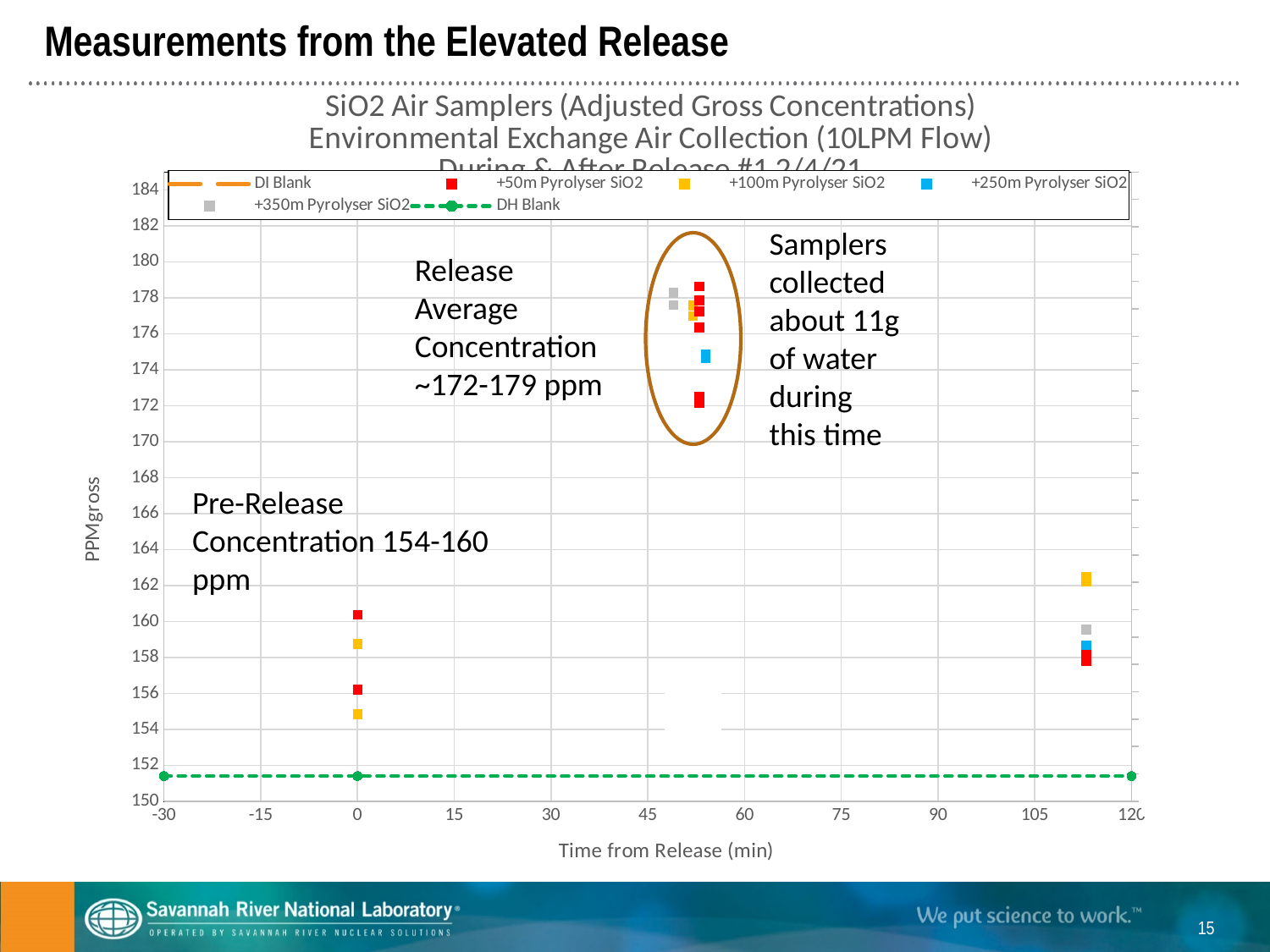
Is the +100m Pyrolyser SiO2 value at around 113 min greater or less than 160? greater At time 0, which series has the lowest plotted value? +100m Pyrolyser SiO2 At around 113 min, which is larger: the +100m Pyrolyser SiO2 value or the +50m Pyrolyser SiO2 value? +100m Pyrolyser SiO2 At around 113 min, which series has the highest value? +100m Pyrolyser SiO2 Is the DH Blank value at time 0 greater or less than 152? less What is the x-axis title of the chart? Time from Release (min) What kind of chart is shown on the slide? scatter chart Is the +250m Pyrolyser SiO2 value in the circled cluster (around 52 min) greater or less than 176? less Does the DH Blank series rise, fall, or stay flat across the x axis? stays flat How many series does the chart legend list? 6 What is the y-axis title of the chart? PPMgross